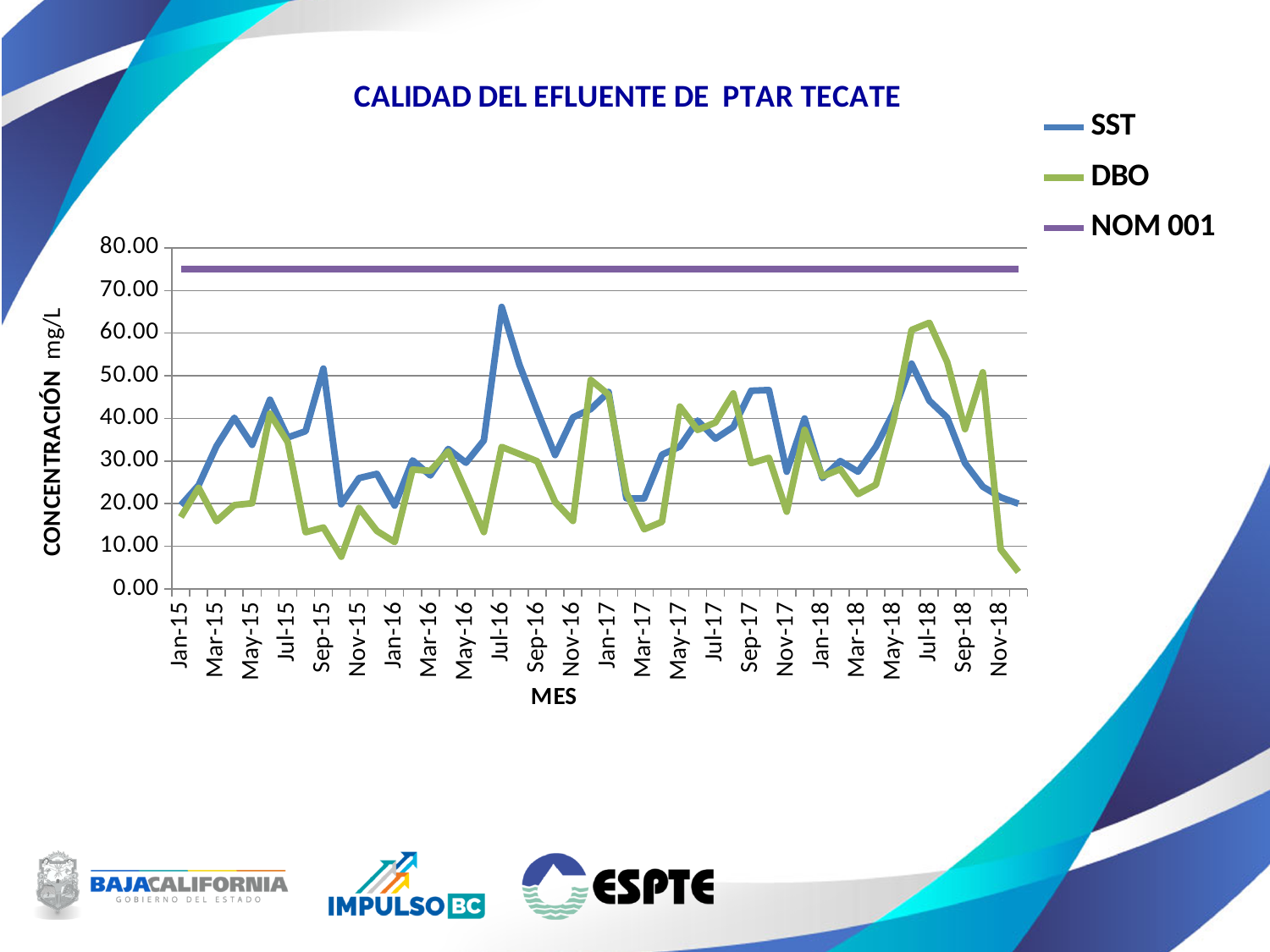
Is the SST value at Jan-15 greater or less than 30.00? less Is the NOM 001 line greater or less than 70.00? greater At Jul-16, which series has the larger value, SST or DBO? SST What kind of chart is shown on the slide? Line chart What is the label of the vertical axis? CONCENTRACIÓN mg/L How many series does the legend list? 3 What is the title of the chart? CALIDAD DEL EFLUENTE DE PTAR TECATE At Jul-18, which series has the larger value, SST or DBO? DBO In which month does the SST series reach its highest value? Jul-16 Does the SST series rise or fall from Jul-18 to Nov-18? Fall Is the DBO value at Jan-16 greater or less than 20.00? less